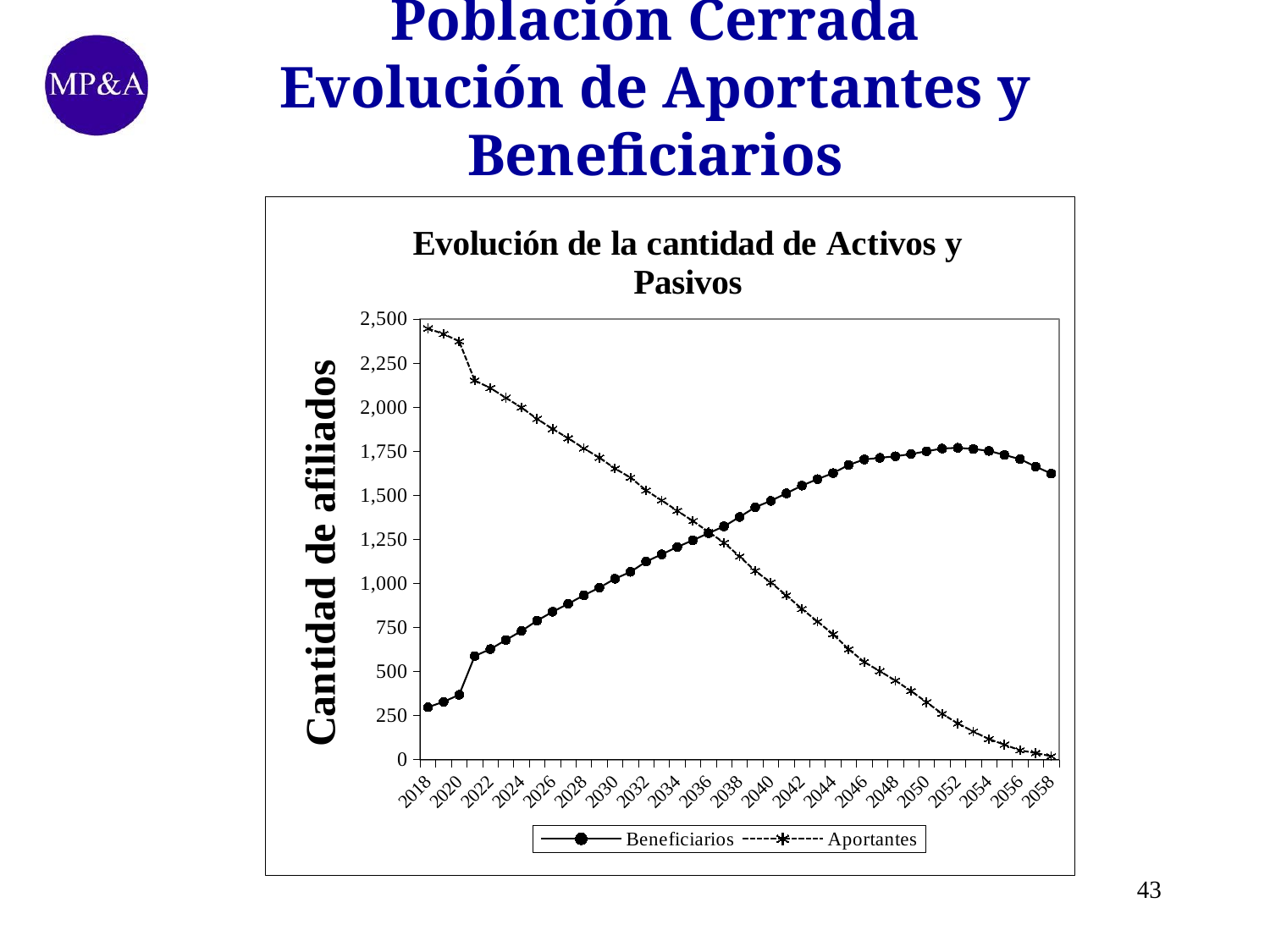
Is the value for Beneficiarios in 2052 greater or less than 1,500? greater Does the Beneficiarios series rise or fall between 2018 and 2050? Rise How many series does the legend list? 2 Does the Aportantes series rise or fall from 2018 to 2058? Fall Is the value for Aportantes in 2018 greater or less than 2,250? greater In 2018, which series has the higher value, Beneficiarios or Aportantes? Aportantes What kind of chart is shown on the slide? Line chart Is the value for Beneficiarios in 2018 greater or less than 500? less What is the title of the chart? Evolución de la cantidad de Activos y Pasivos What is the label on the vertical axis of the chart? Cantidad de afiliados In 2050, which series has the higher value, Beneficiarios or Aportantes? Beneficiarios